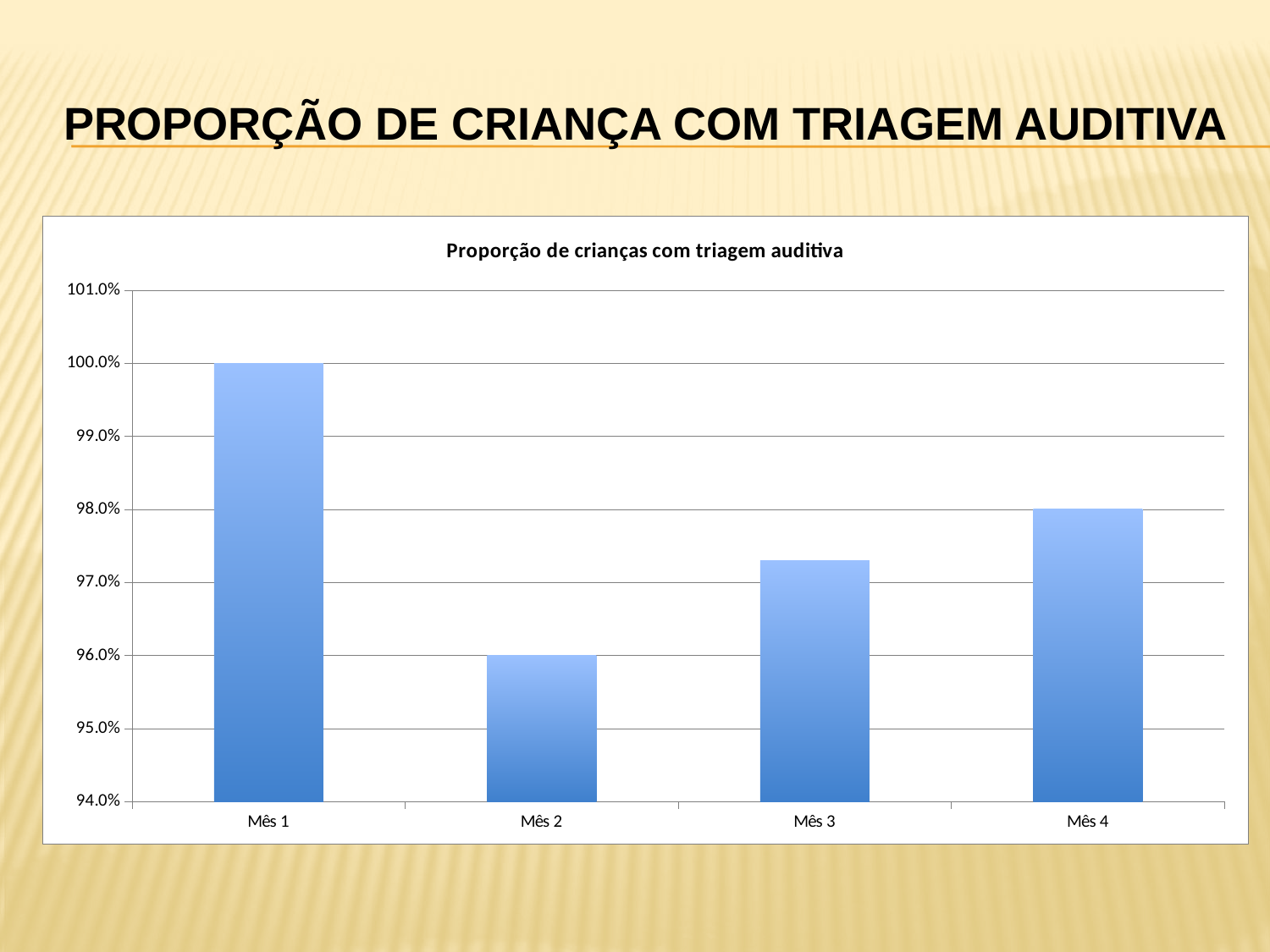
How many categories (months) are shown on the x axis? 4 Which is larger, the value for Mês 3 or the value for Mês 4? Mês 4 Which month has the highest proportion of children with hearing screening? Mês 1 Do the values rise or fall from Mês 2 to Mês 4? rise What is the value for Mês 1? 100.0% What is the difference between the values for Mês 1 and Mês 2? 4.0% Is the value for Mês 3 greater or less than 97.0%? greater Which month has the lowest proportion of children with hearing screening? Mês 2 Is the value for Mês 3 greater or less than 98.0%? less What is the title of the chart? Proporção de crianças com triagem auditiva What is the value for Mês 2? 96.0% What type of chart is shown on the slide? bar chart